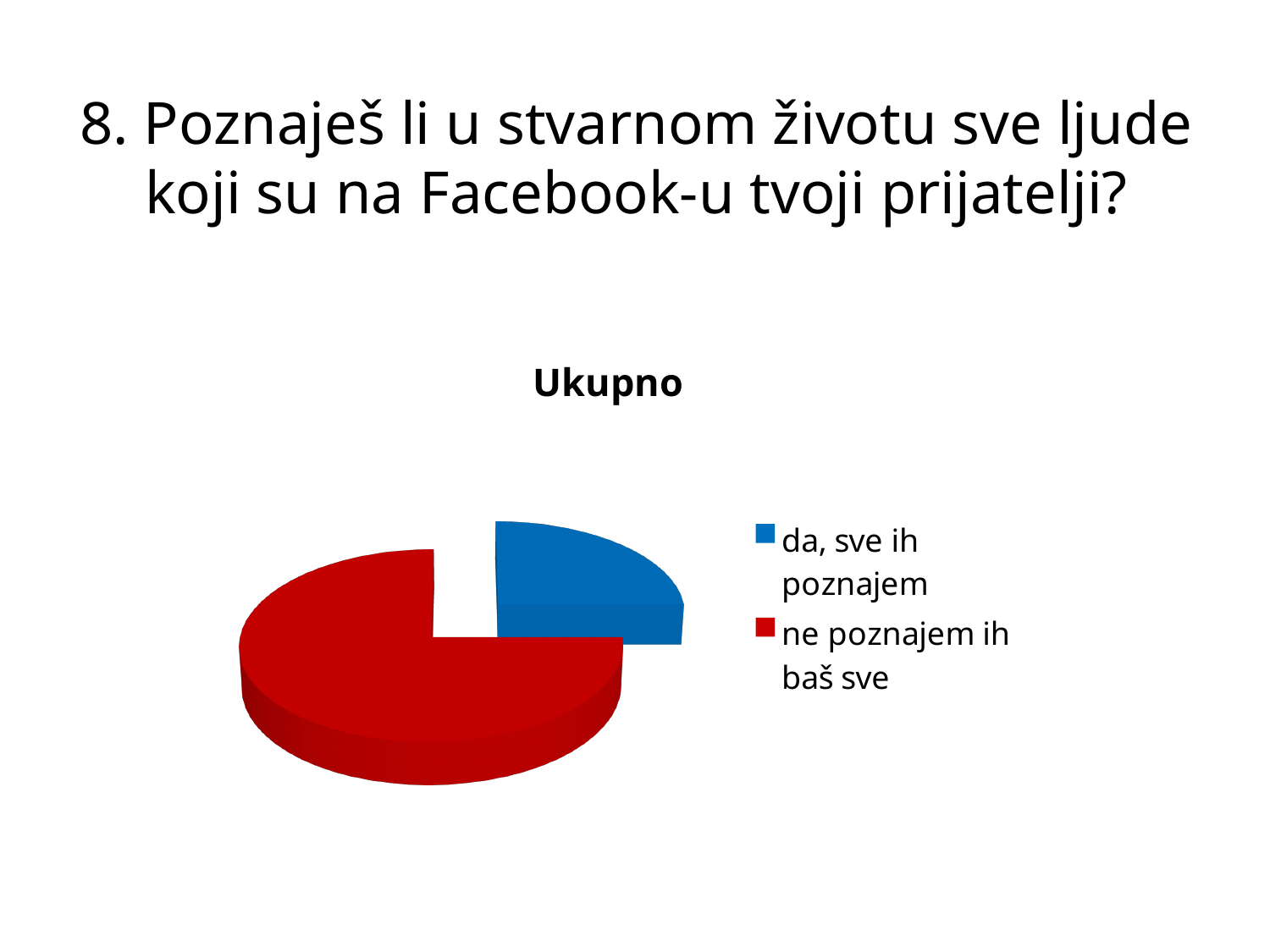
How many categories does the legend list? 2 Which category has the largest slice of the pie? ne poznajem ih baš sve What kind of chart is shown on the slide? pie chart What colour is the slice for "da, sve ih poznajem"? blue Which category has the smallest slice of the pie? da, sve ih poznajem What is the title of the chart? Ukupno Which slice is larger: "da, sve ih poznajem" or "ne poznajem ih baš sve"? ne poznajem ih baš sve